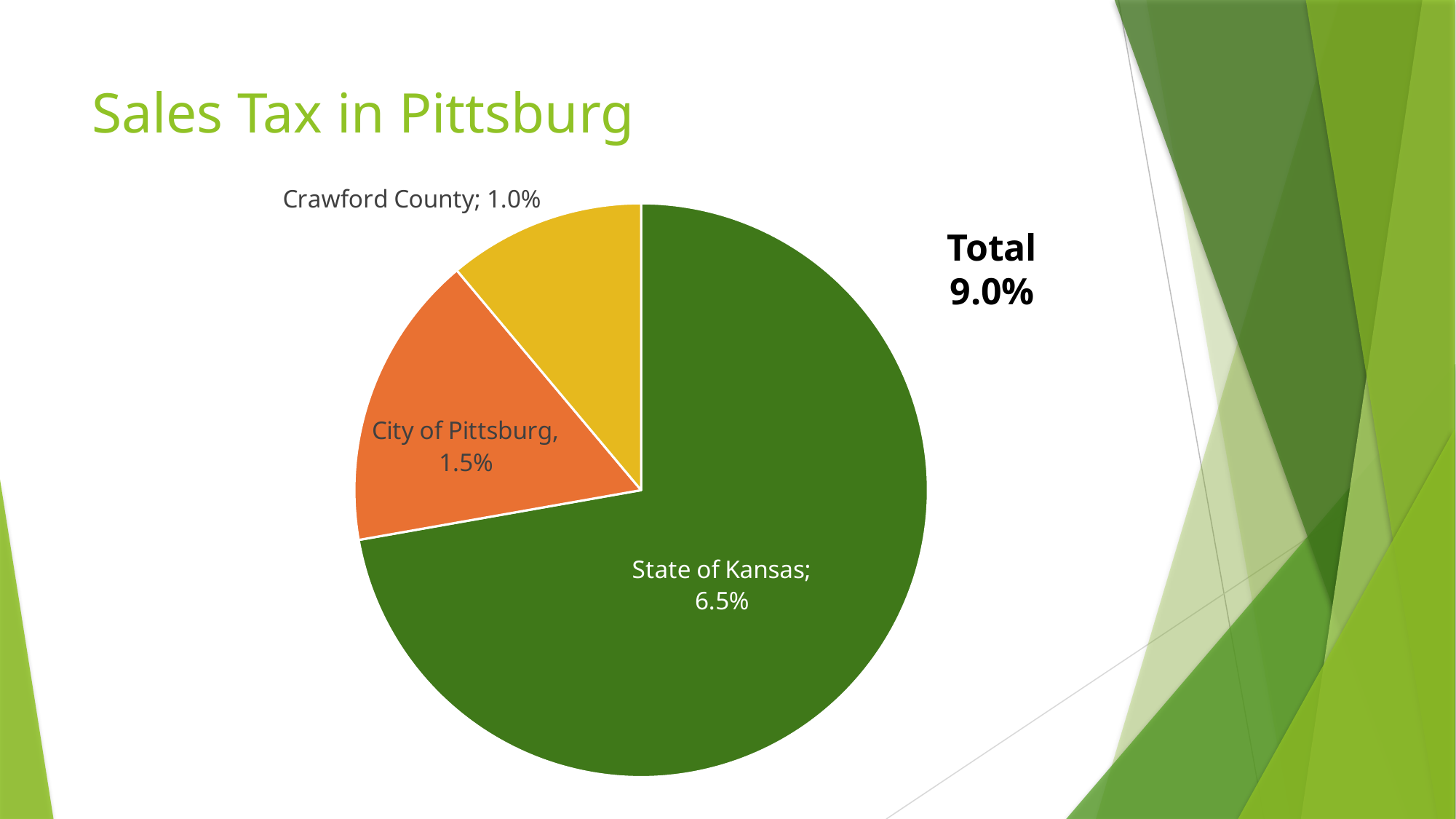
How many slices does the pie chart have? 3 What is the difference between the City of Pittsburg rate and the Crawford County rate? 0.5% What total sales tax rate is shown next to the pie chart? 9.0% What kind of chart is shown on the slide? pie chart What is the sales tax rate for the State of Kansas? 6.5% What is the sales tax rate for Crawford County? 1.0% Which is larger, the City of Pittsburg rate or the Crawford County rate? City of Pittsburg What is the difference between the State of Kansas rate and the City of Pittsburg rate? 5.0% What colour is the State of Kansas slice? green What is the sales tax rate for the City of Pittsburg? 1.5% Which slice of the pie is the largest? State of Kansas Which slice of the pie is the smallest? Crawford County